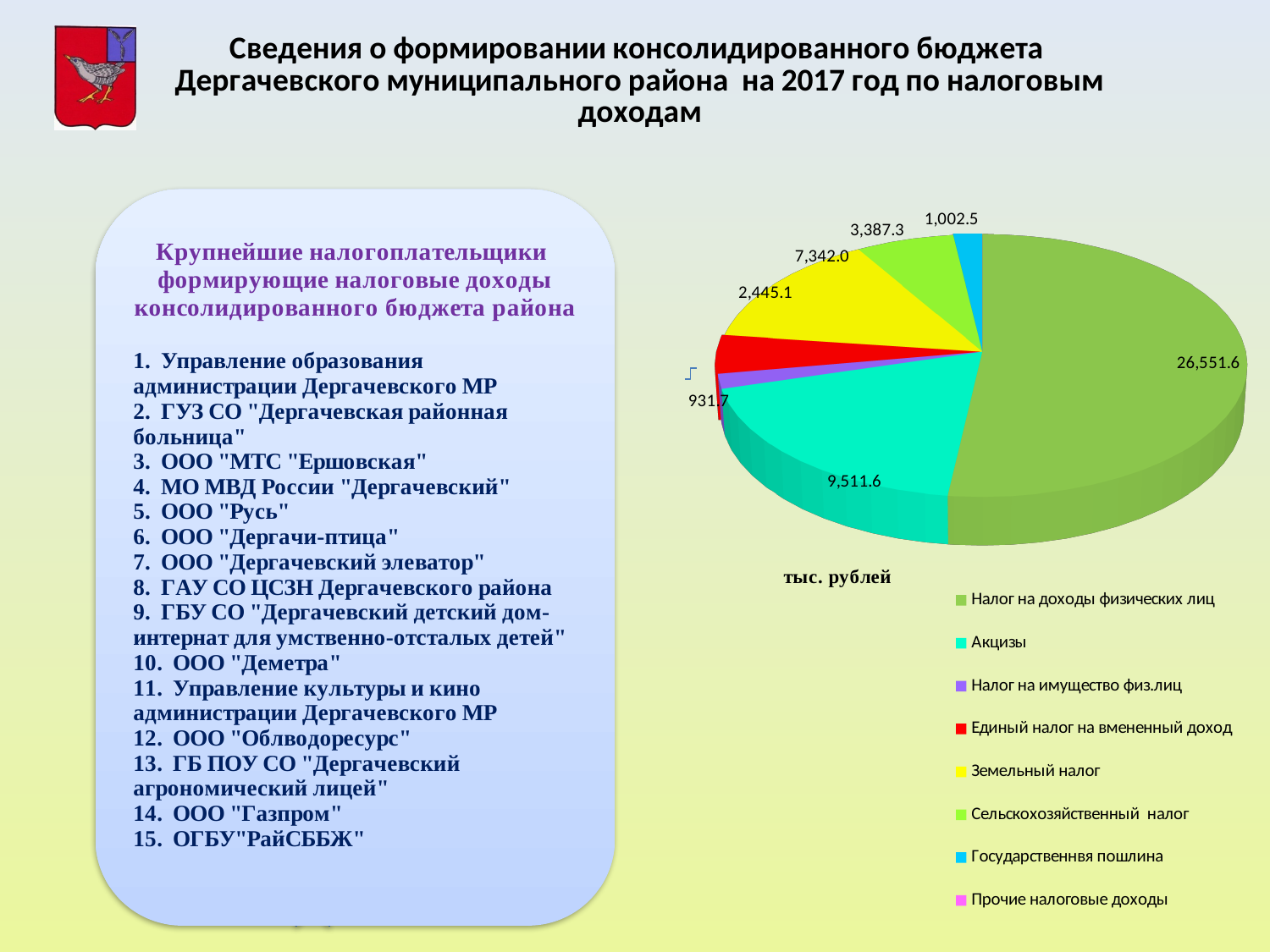
How many categories does the legend list? 8 Which category has the largest slice of the pie? Налог на доходы физических лиц Which is larger, Акцизы or Земельный налог? Акцизы What type of chart is shown on the slide? pie chart What is the value for Земельный налог? 7,342.0 What is the value for Налог на доходы физических лиц? 26,551.6 What is the value for Государственная пошлина? 1,002.5 What is the value for Акцизы? 9,511.6 In what units are the chart values given? тыс. рублей What is the difference between Налог на доходы физических лиц and Акцизы? 17,040.0 What is the value for Сельскохозяйственный налог? 3,387.3 What is the value for Единый налог на вмененный доход? 2,445.1